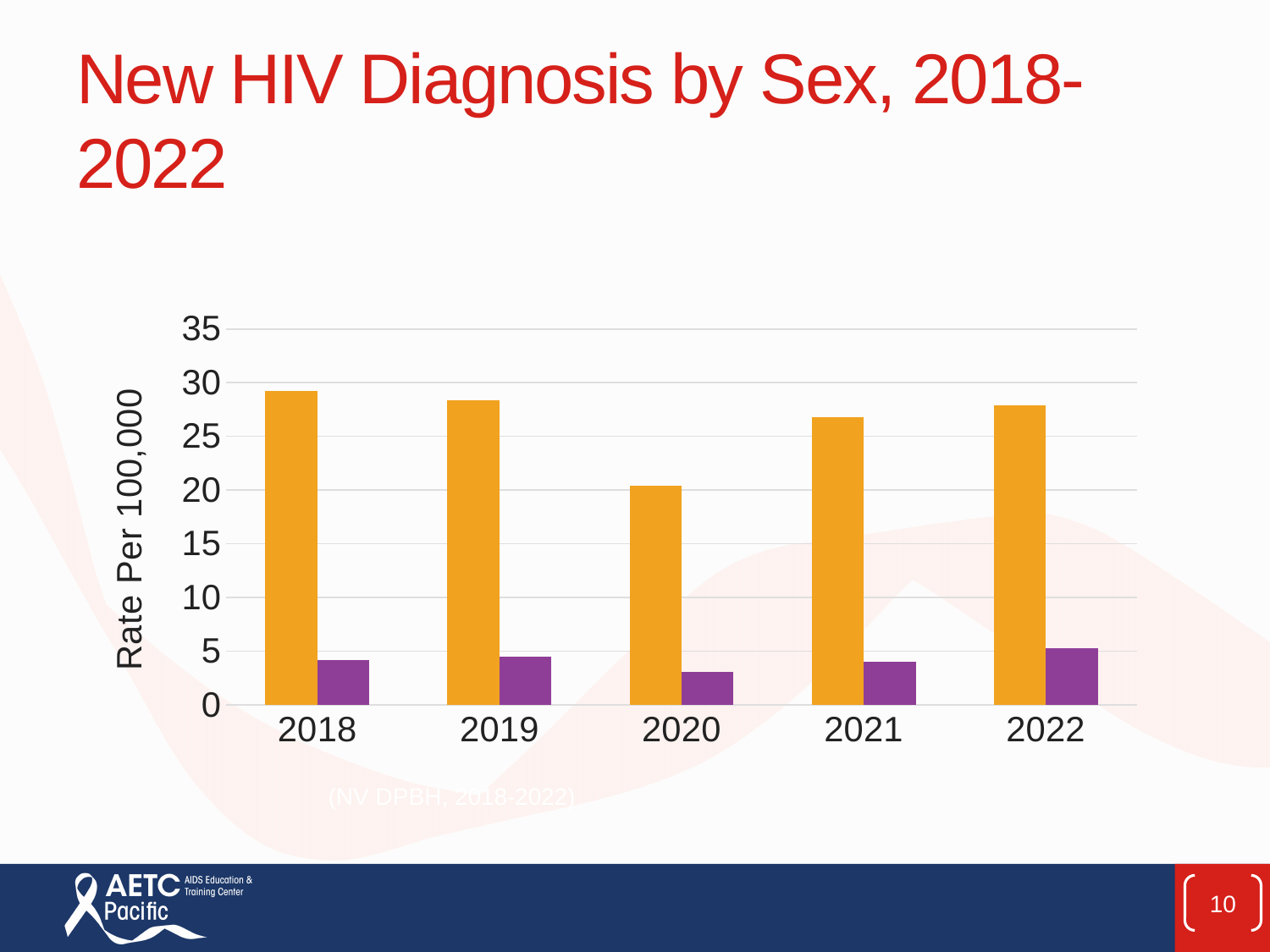
Which year has the lowest purple bar? 2020 Is the orange bar for 2018 greater or less than 25? greater How many years are shown on the x axis of the chart? 5 Is the orange bar for 2020 greater or less than 25? less Which year has the lowest orange bar? 2020 Is the purple bar for 2020 greater or less than 5? less What kind of chart is shown on the slide? bar chart Which year has the taller orange bar, 2020 or 2021? 2021 In 2022, which bar is taller, the orange bar or the purple bar? orange What is the label on the vertical axis of the chart? Rate Per 100,000 What is the title of the chart on the slide? New HIV Diagnosis by Sex, 2018-2022